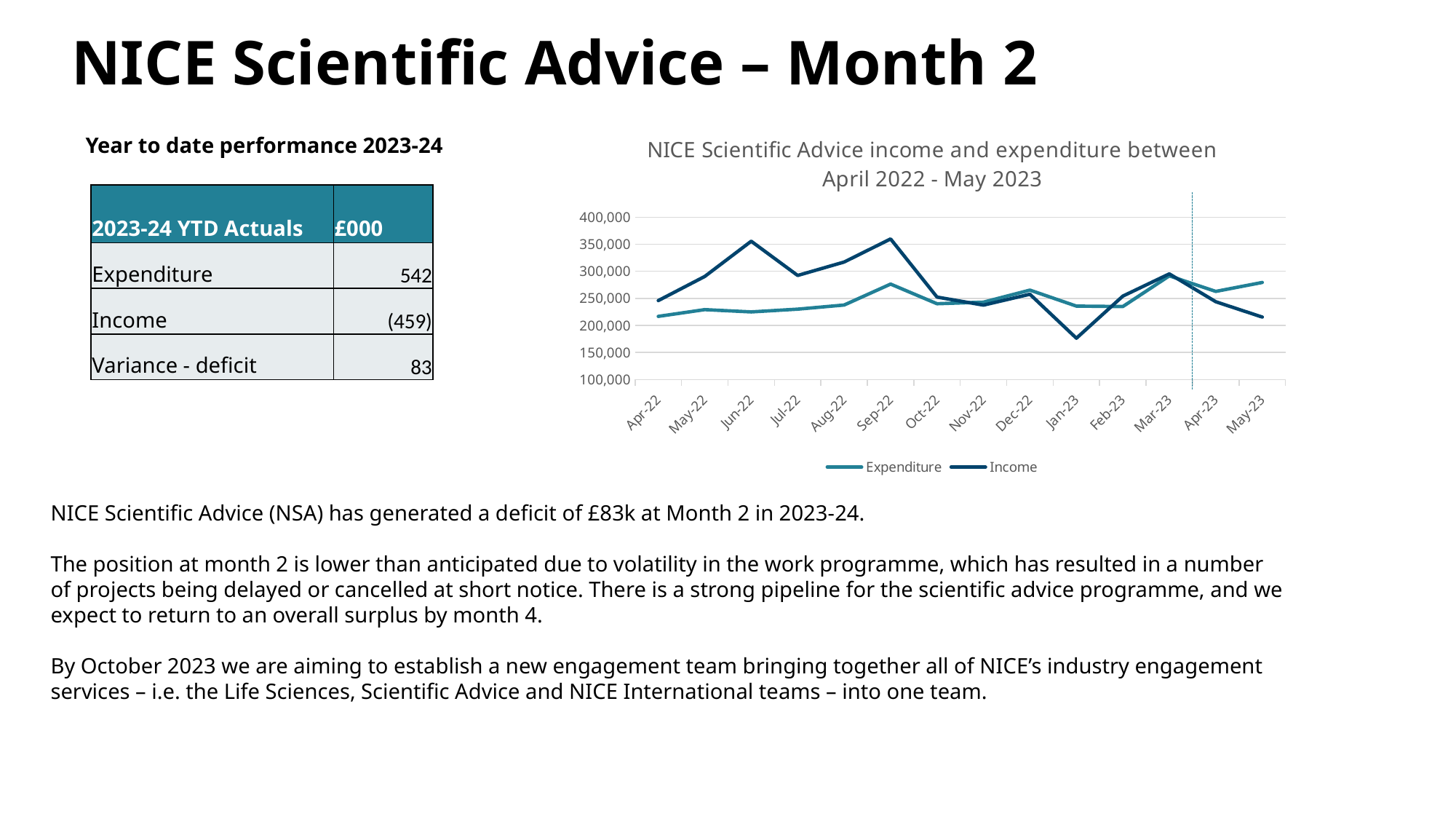
In which month is Income at its lowest on the chart? Jan-23 Is the Income value for Sep-22 greater or less than 350,000? greater In Sep-22, which is larger, Income or Expenditure? Income In May-23, which is larger, Income or Expenditure? Expenditure Does Income rise or fall from Jun-22 to Jul-22? fall Is the Income value for Jan-23 greater or less than 200,000? less How many series does the chart legend list? 2 What kind of chart is shown on the slide? line chart Is the Expenditure value for Apr-22 greater or less than 250,000? less What is the title of the chart? NICE Scientific Advice income and expenditure between April 2022 - May 2023 How many months are plotted along the x axis of the chart? 14